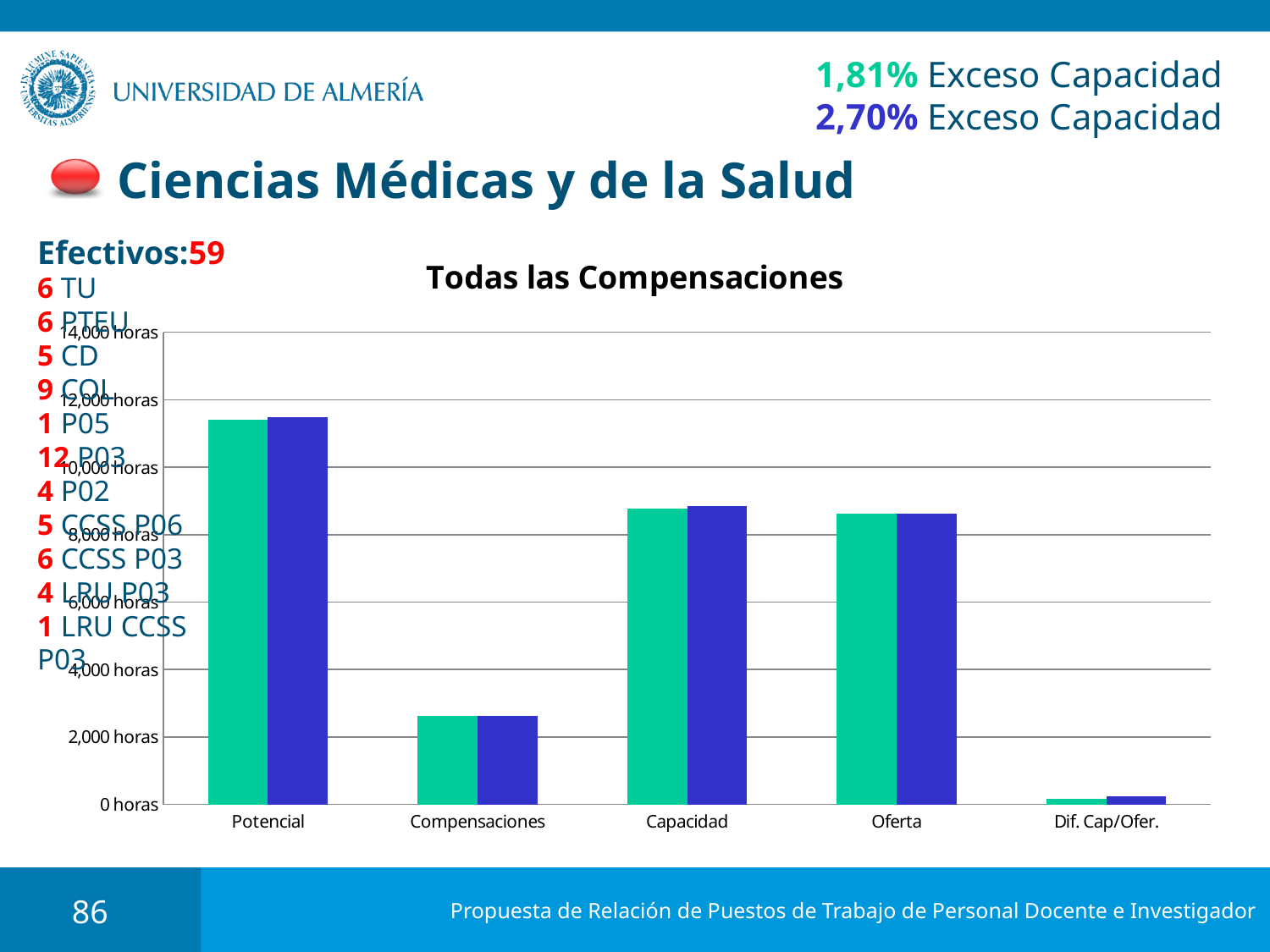
Which is larger, the value for Potencial or the value for Compensaciones? Potencial Which is larger, the value for Capacidad or the value for Dif. Cap/Ofer.? Capacidad Is the value for Capacidad greater or less than 8,000 horas? greater What kind of chart is shown under the title "Todas las Compensaciones"? bar chart What is the highest tick label shown on the y axis of the chart? 14,000 horas Is the value for Potencial greater or less than 10,000 horas? greater Which category has the lowest bars in the "Todas las Compensaciones" chart? Dif. Cap/Ofer. Is the value for Compensaciones greater or less than 4,000 horas? less What is the title of the chart on the slide? Todas las Compensaciones Which category has the highest bars in the "Todas las Compensaciones" chart? Potencial How many categories are shown on the x axis of the "Todas las Compensaciones" chart? 5